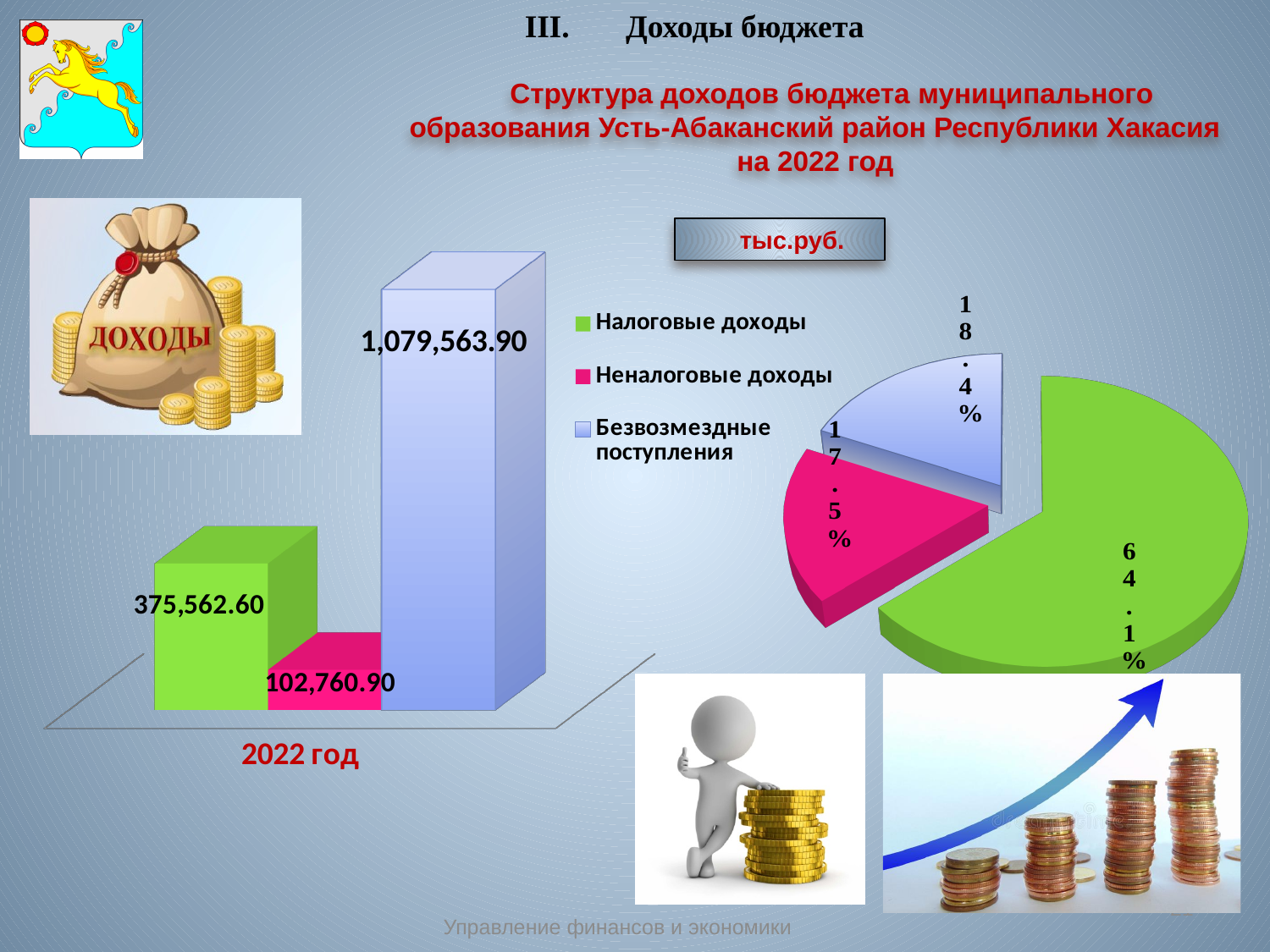
On the bar chart, which is larger: Налоговые доходы or Безвозмездные поступления? Безвозмездные поступления On the bar chart, which series has the highest value? Безвозмездные поступления On the bar chart, what is the value for Безвозмездные поступления in 2022? 1,079,563.90 On the bar chart, what is the value for Налоговые доходы in 2022? 375,562.60 On the pie chart, which slice is the largest? Налоговые доходы (64.1%) On the bar chart, what is the difference between Налоговые доходы and Неналоговые доходы? 272,801.70 On the pie chart, what share does the green slice (Налоговые доходы) have? 64.1% On the bar chart, what is the value for Неналоговые доходы in 2022? 102,760.90 On the pie chart, what share does the pink slice (Неналоговые доходы) have? 17.5% How many series does the legend list? 3 What kind of chart is the chart on the left of the slide? Bar chart On the bar chart, which series has the lowest value? Неналоговые доходы